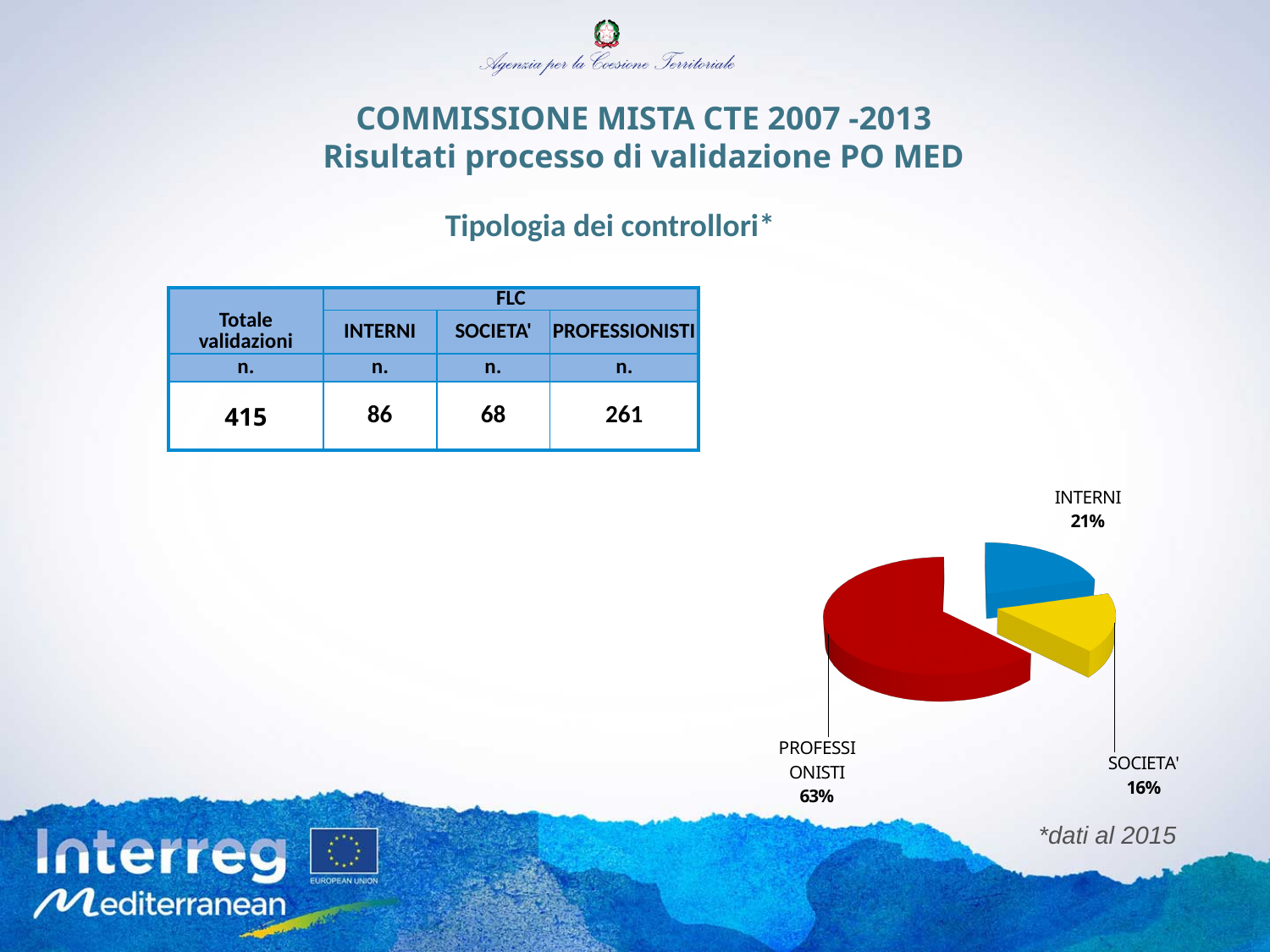
What share of the pie chart does PROFESSIONISTI represent? 63% What colour is the INTERNI slice in the pie chart? blue What is the difference in percentage points between the PROFESSIONISTI slice and the INTERNI slice? 42 What colour is the PROFESSIONISTI slice in the pie chart? red What share of the pie chart does INTERNI represent? 21% Which category has the largest slice in the pie chart? PROFESSIONISTI Which category has the smallest slice in the pie chart? SOCIETA' What share of the pie chart does SOCIETA' represent? 16% What kind of chart is shown on the slide? pie chart How many slices does the pie chart have? 3 What is the difference in percentage points between the INTERNI slice and the SOCIETA' slice? 5 Which slice is larger in the pie chart, INTERNI or SOCIETA'? INTERNI